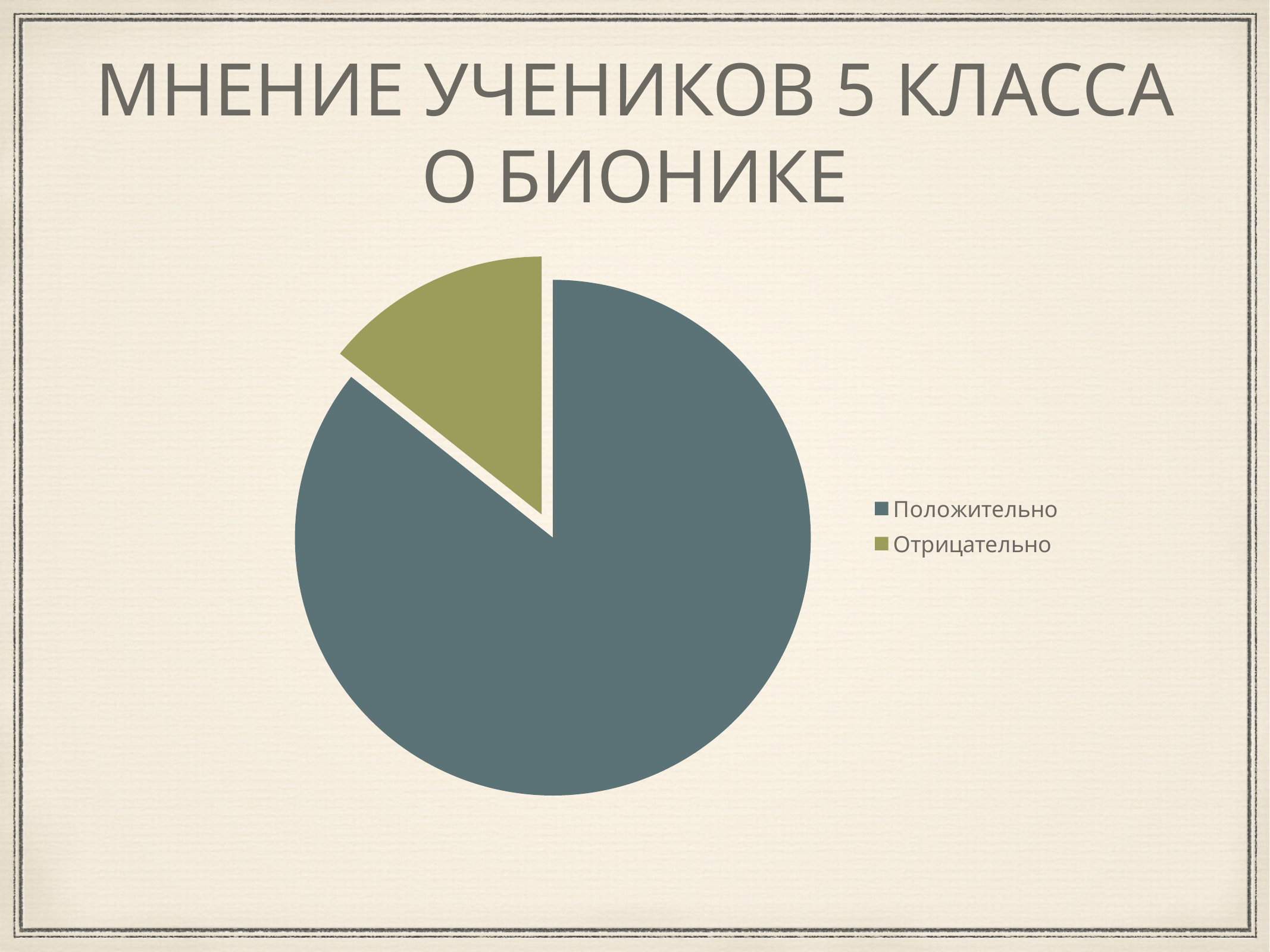
How many slices does the pie chart have? 2 Does Отрицательно account for more or less than half of the pie? less How many entries does the legend list? 2 Which category has the largest slice of the pie? Положительно What kind of chart is shown on the slide? pie chart Which legend entry is shown in green? Отрицательно What is the title of the slide containing the chart? МНЕНИЕ УЧЕНИКОВ 5 КЛАССА О БИОНИКЕ Which category has the smallest slice of the pie? Отрицательно Which slice is larger, Положительно or Отрицательно? Положительно